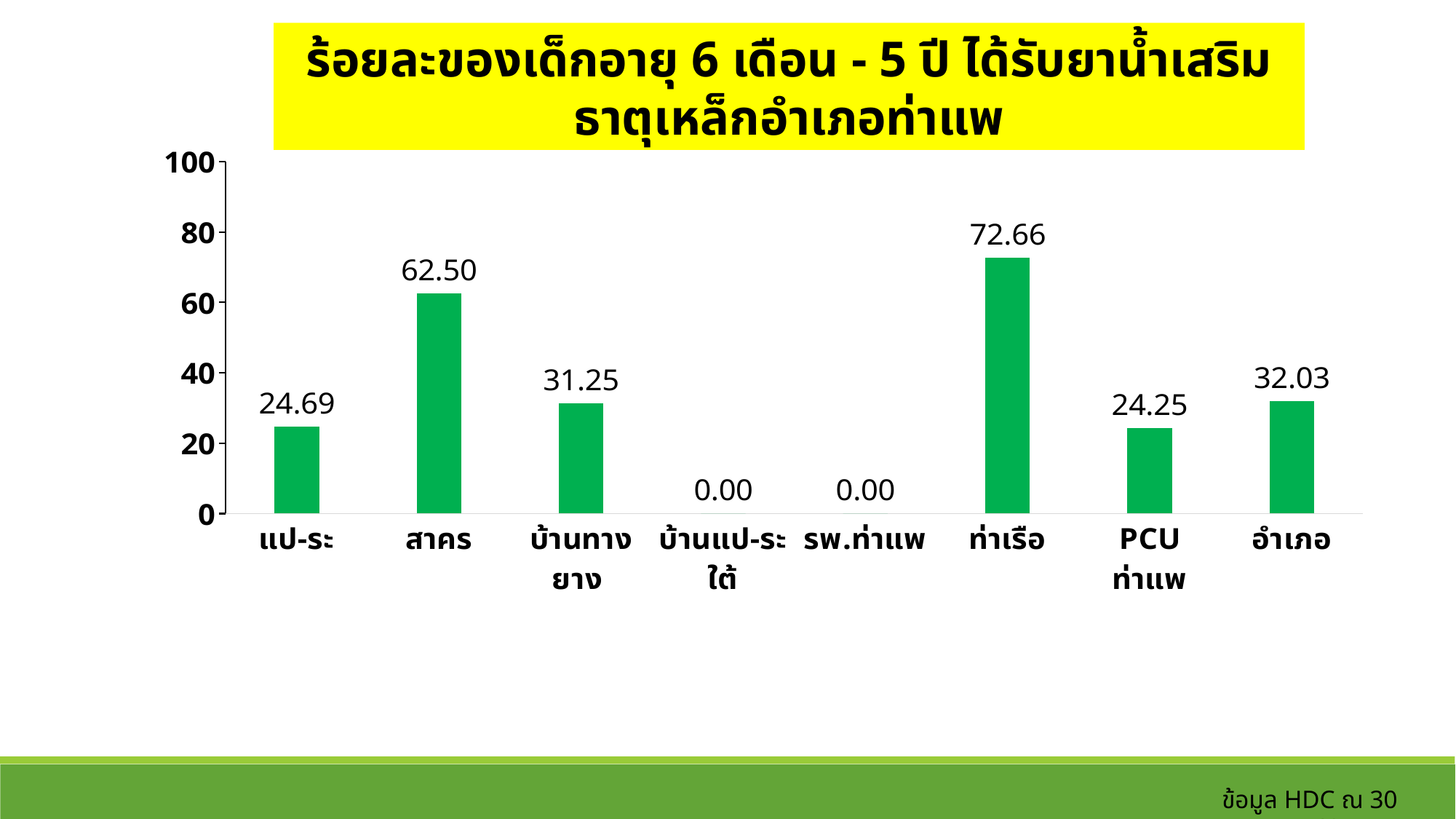
What is the value for ท่าเรือ? 72.66 Which is larger, the value for แป-ระ or the value for บ้านทางยาง? บ้านทางยาง What is the difference between the values for อำเภอ and บ้านทางยาง? 0.78 What is the difference between the values for ท่าเรือ and สาคร? 10.16 What kind of chart is shown on the slide? Bar chart What is the value for PCU ท่าแพ? 24.25 How many categories are shown on the x axis? 8 What is the value for อำเภอ? 32.03 Is the value for สาคร greater or less than 60? greater Which categories have a value of 0.00? บ้านแป-ระใต้ and รพ.ท่าแพ Which category has the highest value? ท่าเรือ What is the value for สาคร? 62.50